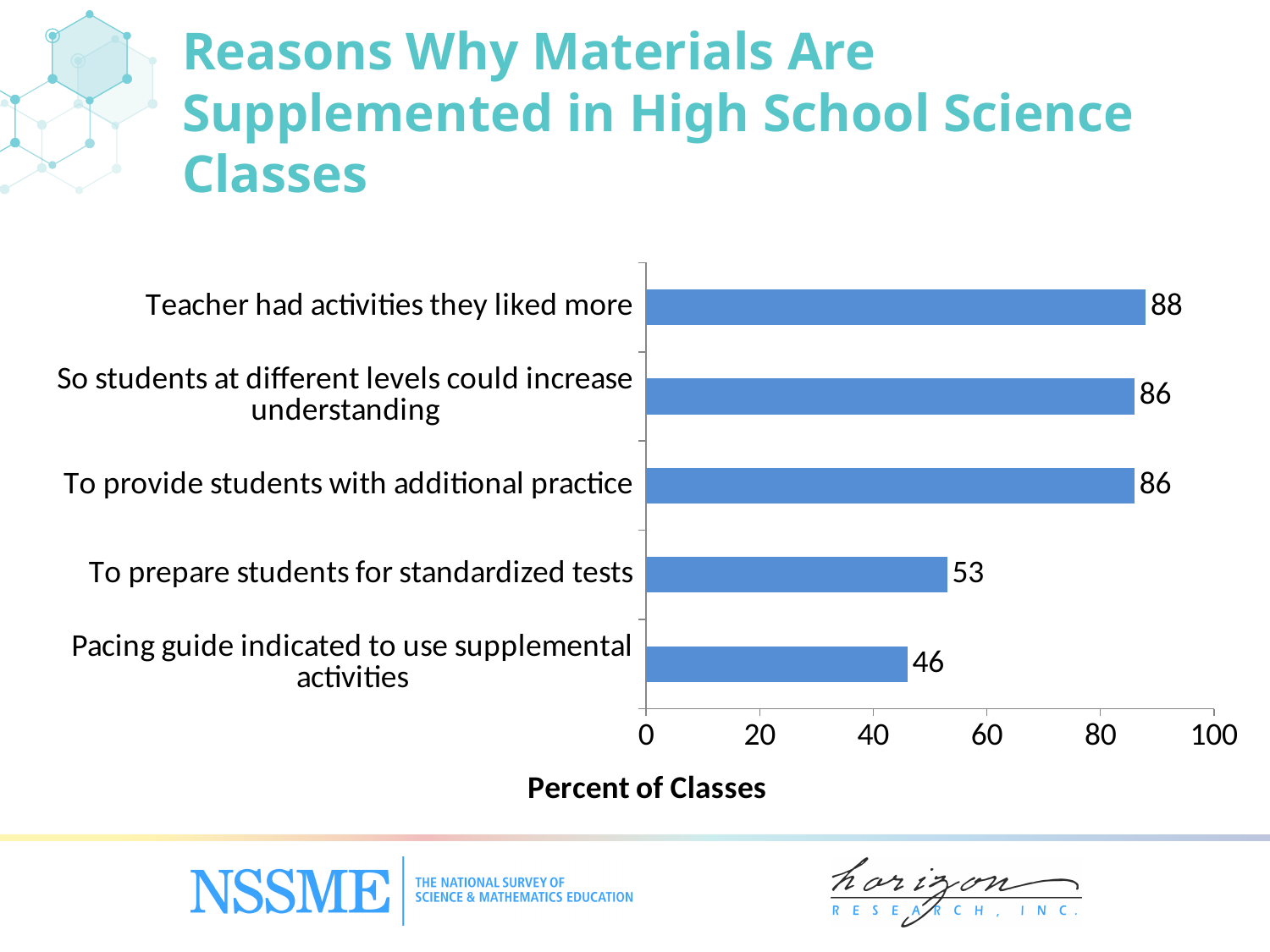
What is the difference between the values for 'To prepare students for standardized tests' and 'Pacing guide indicated to use supplemental activities'? 7 What is the value for 'Pacing guide indicated to use supplemental activities'? 46 How many reasons are shown in the chart? 5 Which reason has the highest percent of classes? Teacher had activities they liked more What kind of chart is shown on the slide? Bar chart What is the label of the horizontal axis? Percent of Classes What is the value for 'To prepare students for standardized tests'? 53 Which is larger: the value for 'To provide students with additional practice' or 'To prepare students for standardized tests'? To provide students with additional practice What percent of classes supplemented materials because the teacher had activities they liked more? 88 Is the value for 'To prepare students for standardized tests' greater or less than 60? less Which reason has the lowest percent of classes? Pacing guide indicated to use supplemental activities What is the difference between the values for 'Teacher had activities they liked more' and 'Pacing guide indicated to use supplemental activities'? 42